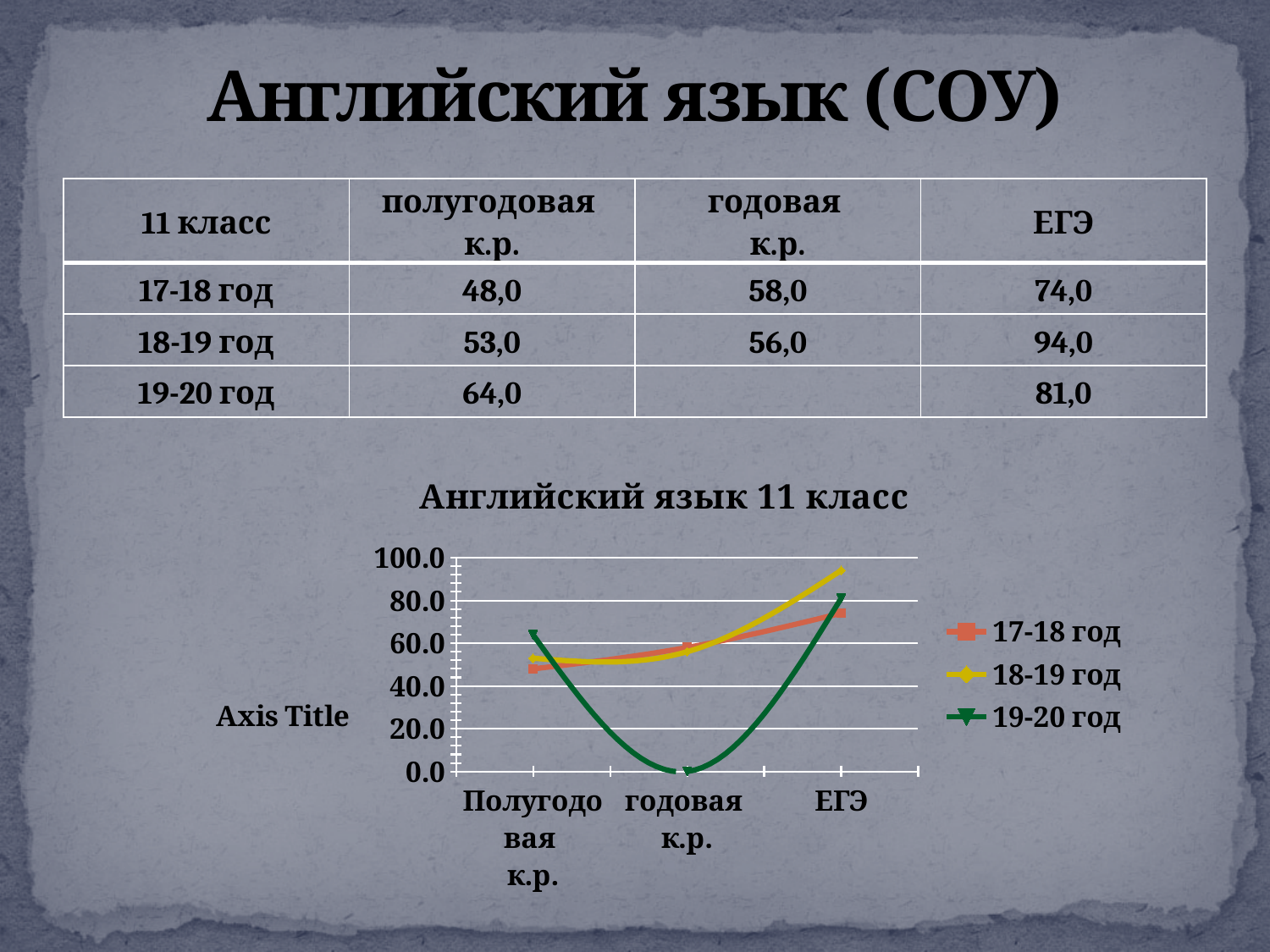
How many categories are shown along the x axis of the chart? 3 Which series has the highest value at ЕГЭ in the chart? 18-19 год Is the value for 17-18 год at ЕГЭ greater or less than 80? less What kind of chart is shown under the title "Английский язык 11 класс"? line chart Which is larger at годовая к.р.: the value for 17-18 год or for 19-20 год? 17-18 год What colour is the line for the 19-20 год series in the chart? green How many series does the legend of the chart list? 3 What is the ЕГЭ value for 18-19 год shown on the slide? 94,0 Do the values for the 18-19 год series rise or fall from полугодовая к.р. to ЕГЭ? rise Which series has the lowest value at полугодовая к.р. in the chart? 17-18 год What is the difference between the ЕГЭ values for 18-19 год and 17-18 год shown on the slide? 20,0 Is the value for 19-20 год at полугодовая к.р. greater or less than 60? greater